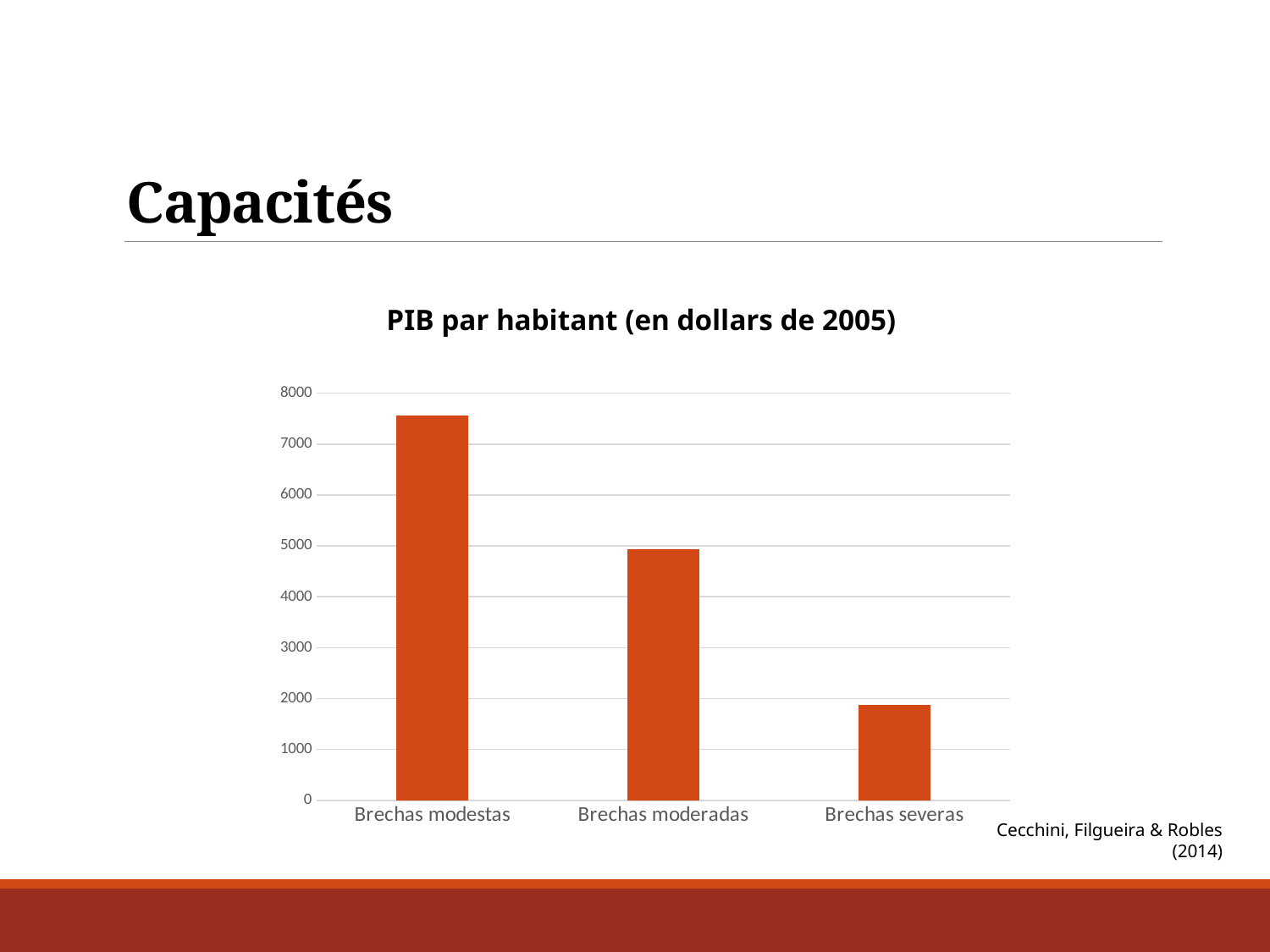
What is the title of the chart? PIB par habitant (en dollars de 2005) Which category has the lowest PIB par habitant? Brechas severas What source is cited below the chart? Cecchini, Filgueira & Robles (2014) Which is larger, the value for Brechas moderadas or the value for Brechas severas? Brechas moderadas Do the values rise or fall moving from left to right along the x axis? fall How many categories are shown on the x axis of the chart? 3 Is the value for Brechas moderadas greater or less than 4000? greater Which category has the highest PIB par habitant? Brechas modestas What type of chart is shown on the slide? bar chart Is the value for Brechas severas greater or less than 1000? greater Is the value for Brechas modestas greater or less than 7000? greater